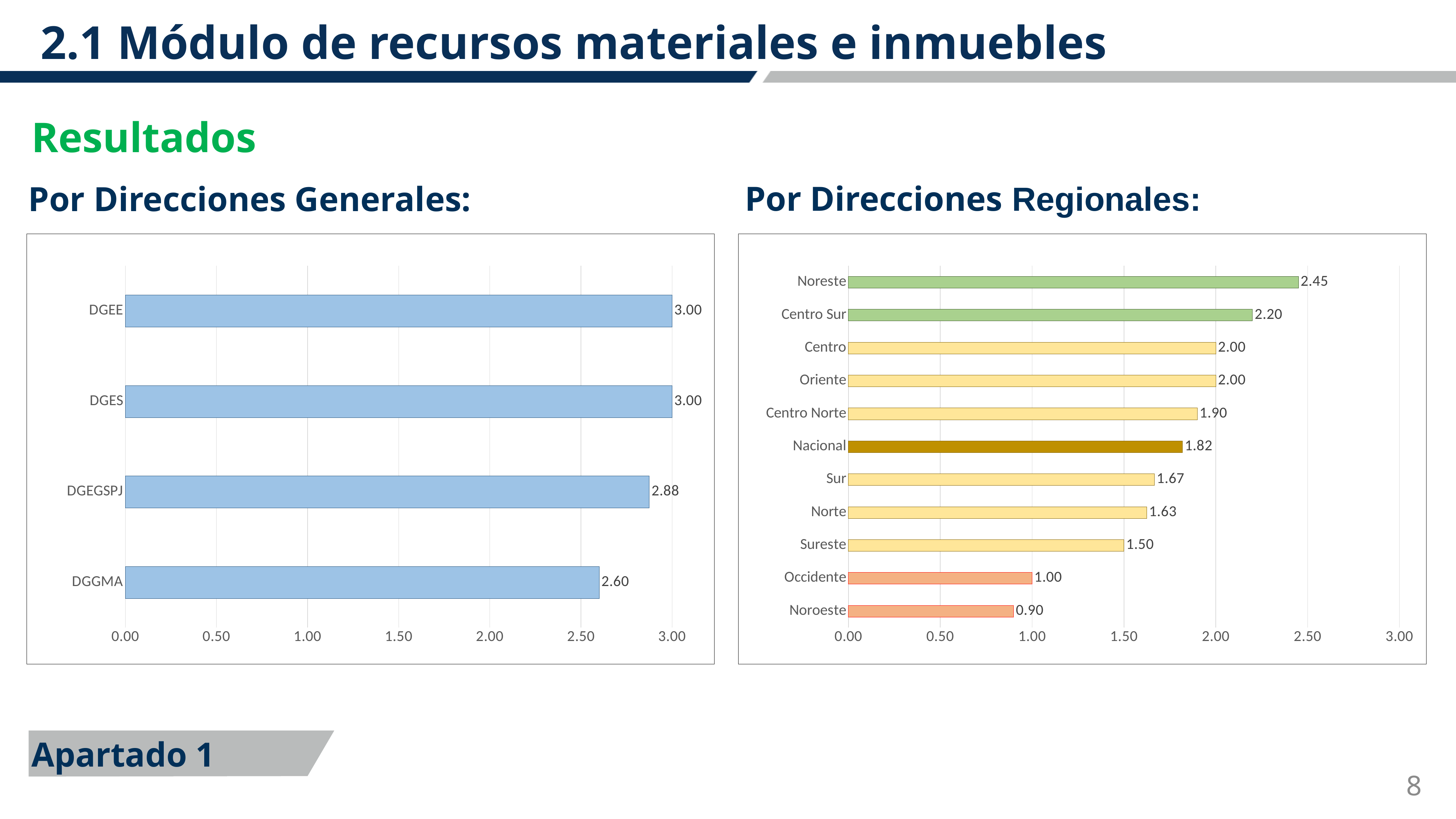
What kind of chart is the 'Por Direcciones Regionales' chart? Bar chart In the 'Por Direcciones Regionales' chart, which category has the lowest value? Noroeste In the 'Por Direcciones Generales' chart, what is the difference between the values for DGEE and DGGMA? 0.40 In the 'Por Direcciones Regionales' chart, what colour is the bar for Nacional? Dark gold In the 'Por Direcciones Regionales' chart, how many categories are shown? 11 In the 'Por Direcciones Regionales' chart, which is larger, the value for Sur or the value for Sureste? Sur In the 'Por Direcciones Generales' chart, which category has the lowest value? DGGMA In the 'Por Direcciones Generales' chart, what is the value for DGEGSPJ? 2.88 In the 'Por Direcciones Regionales' chart, what is the value for Nacional? 1.82 In the 'Por Direcciones Regionales' chart, what is the difference between the values for Noreste and Centro Sur? 0.25 In the 'Por Direcciones Generales' chart, how many categories are shown? 4 In the 'Por Direcciones Regionales' chart, which category has the highest value? Noreste